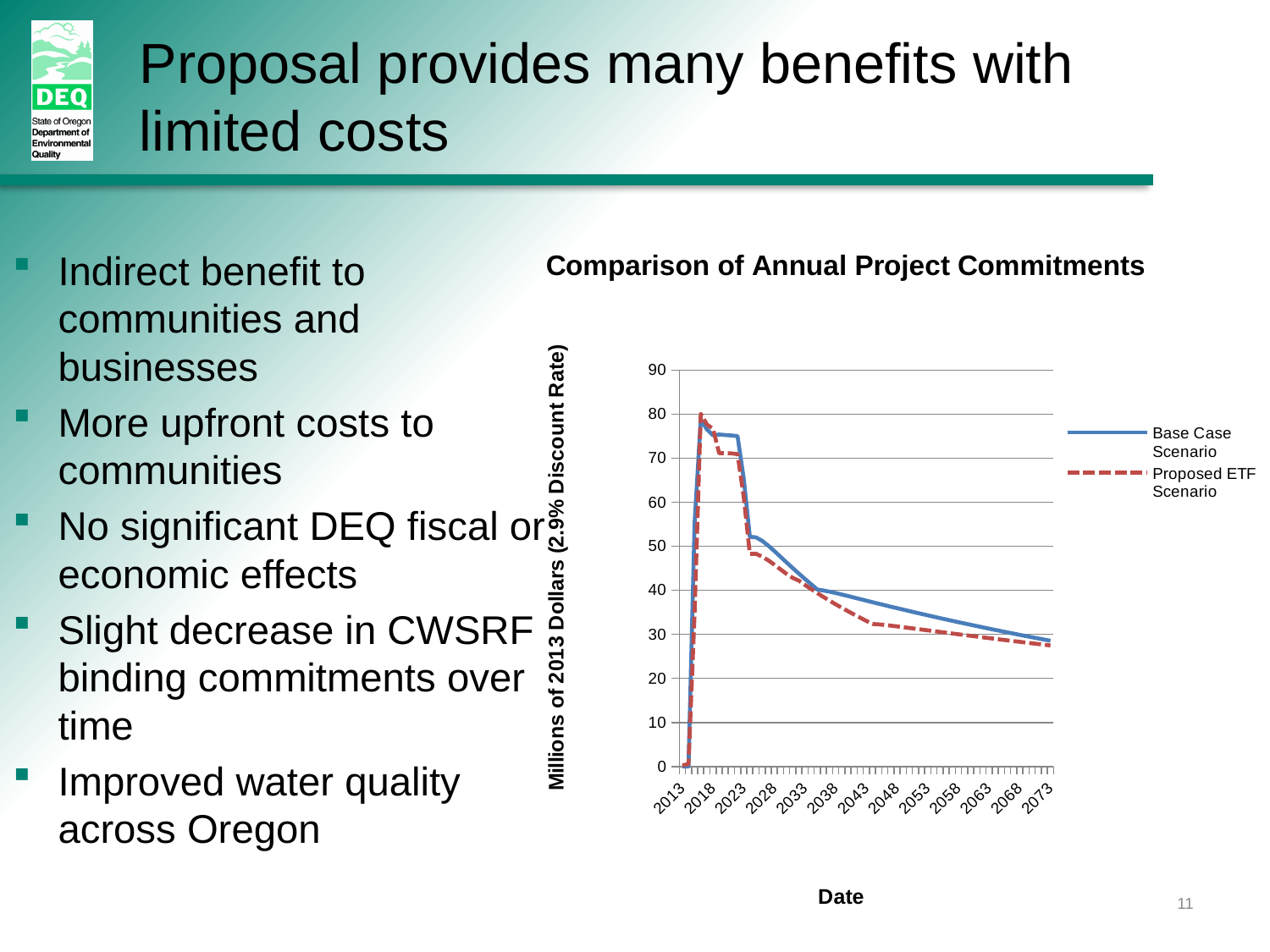
Is the value for the Proposed ETF Scenario in 2018 greater or less than 70? greater Is the value for the Base Case Scenario in 2073 greater or less than 20? greater In 2053, which series has the higher value, Base Case Scenario or Proposed ETF Scenario? Base Case Scenario What is the highest value shown on the y axis of the chart? 90 How many series does the legend of the chart list? 2 What kind of chart is shown on the slide? line chart After the peak around 2018, do the values of the Base Case Scenario rise or fall toward 2073? fall Is the value for the Proposed ETF Scenario in 2043 greater or less than 40? less What is the title of the chart? Comparison of Annual Project Commitments What is the label of the x axis of the chart? Date